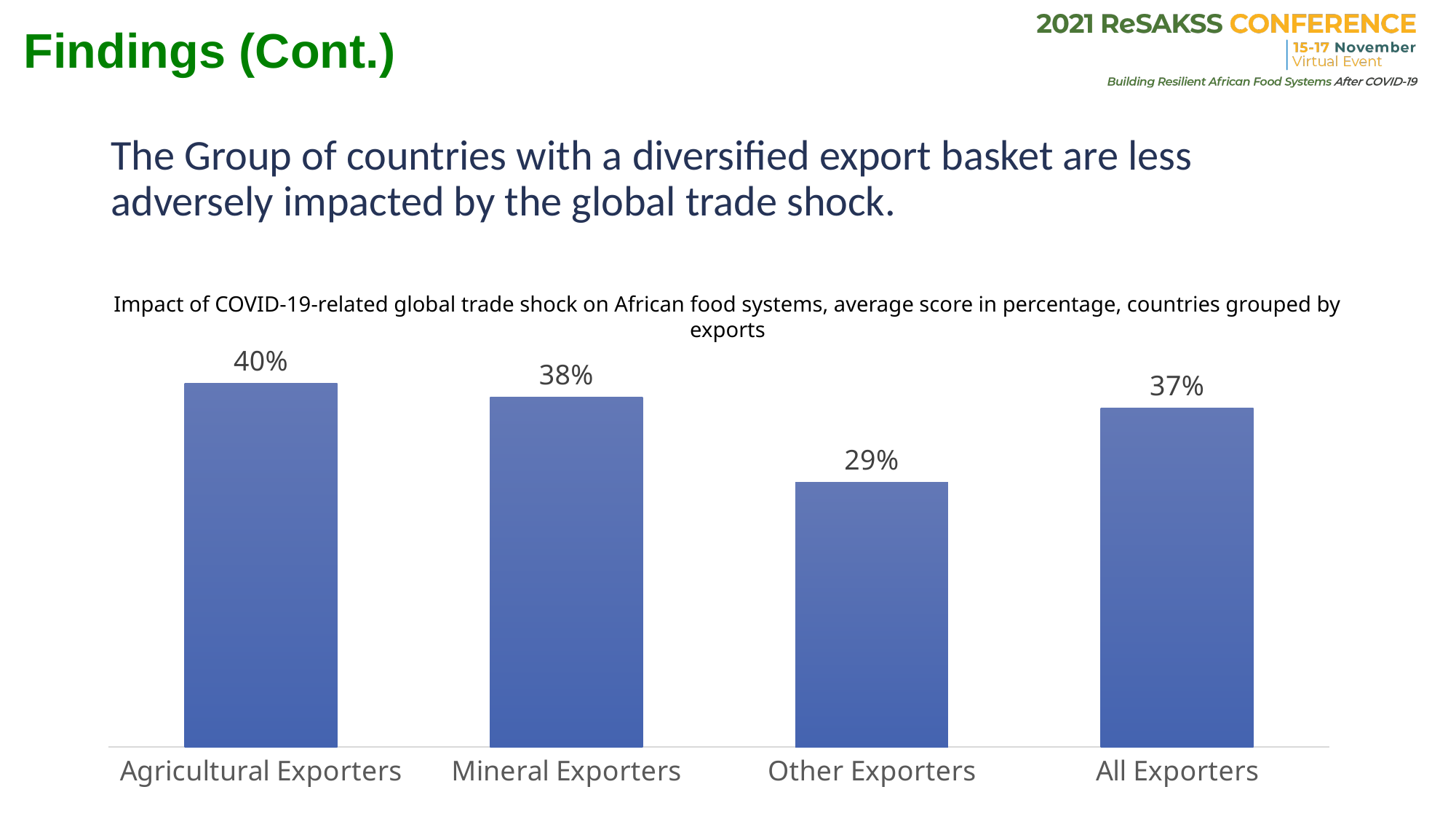
What is the difference between the values for Agricultural Exporters and Other Exporters? 11% What is the value for Mineral Exporters? 38% Which category has the highest value? Agricultural Exporters How many categories are shown in the chart? 4 Which is larger, the value for Mineral Exporters or the value for Other Exporters? Mineral Exporters What is the value for Other Exporters? 29% What is the value for All Exporters? 37% What kind of chart is shown on the slide? Bar chart What is the difference between the values for Mineral Exporters and All Exporters? 1% Which category has the lowest value? Other Exporters What is the title of the chart? Impact of COVID-19-related global trade shock on African food systems, average score in percentage, countries grouped by exports What is the value for Agricultural Exporters? 40%